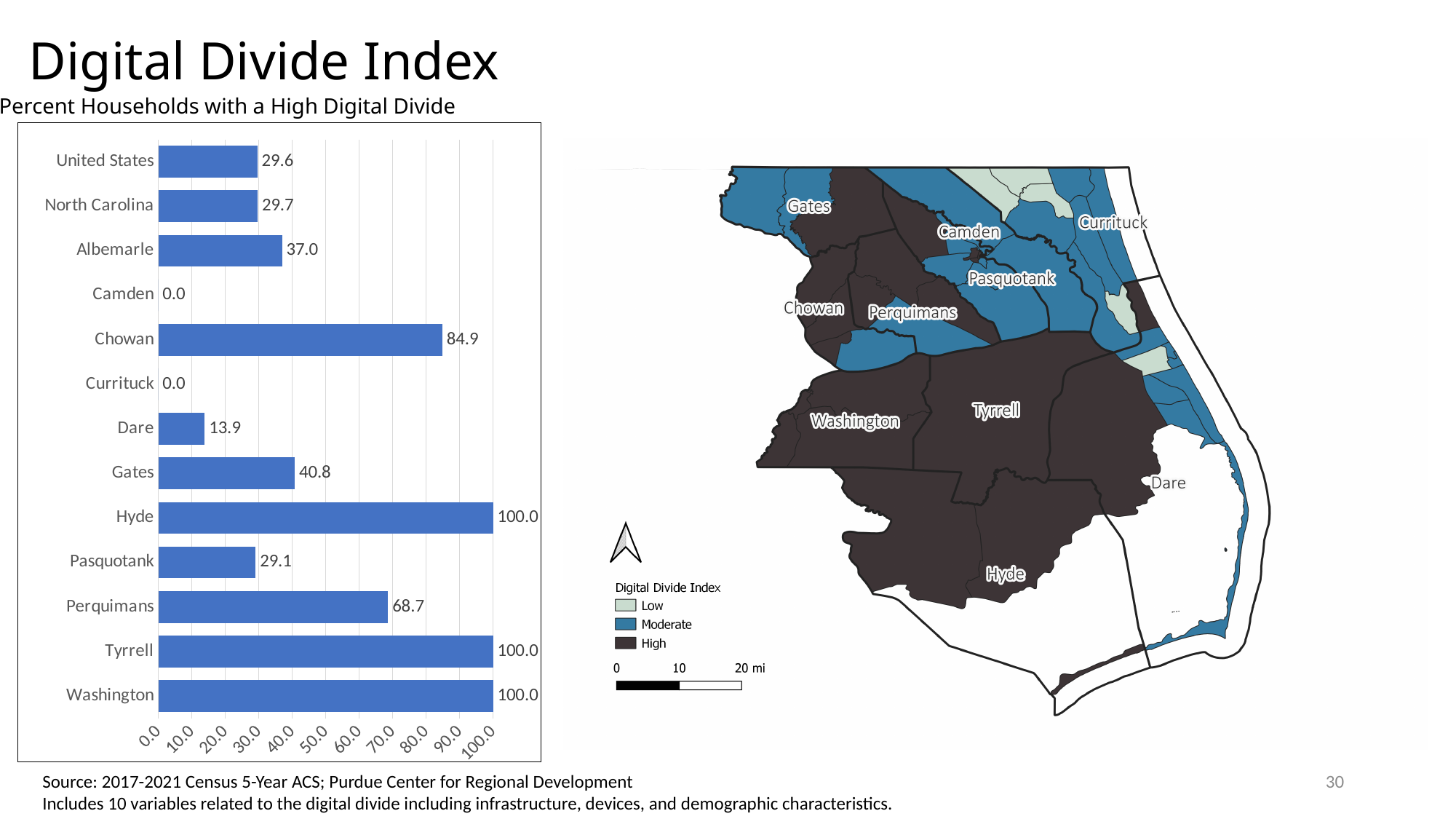
What is the difference between the values for Albemarle and North Carolina in the bar chart? 7.3 What is the value for Dare in the bar chart? 13.9 What is the value for Pasquotank in the bar chart? 29.1 Which categories in the bar chart share the highest value? Hyde, Tyrrell, Washington Is the value for Dare in the bar chart greater or less than 20.0? less Which categories in the bar chart have a value of 0.0? Camden, Currituck What is the value for Chowan in the bar chart? 84.9 What is the value for Albemarle in the bar chart? 37.0 How many categories are shown in the bar chart? 13 What is the difference between the values for Chowan and Perquimans in the bar chart? 16.2 What kind of chart is shown on the left of the slide? bar chart In the bar chart, which has a larger value, Gates or Albemarle? Gates